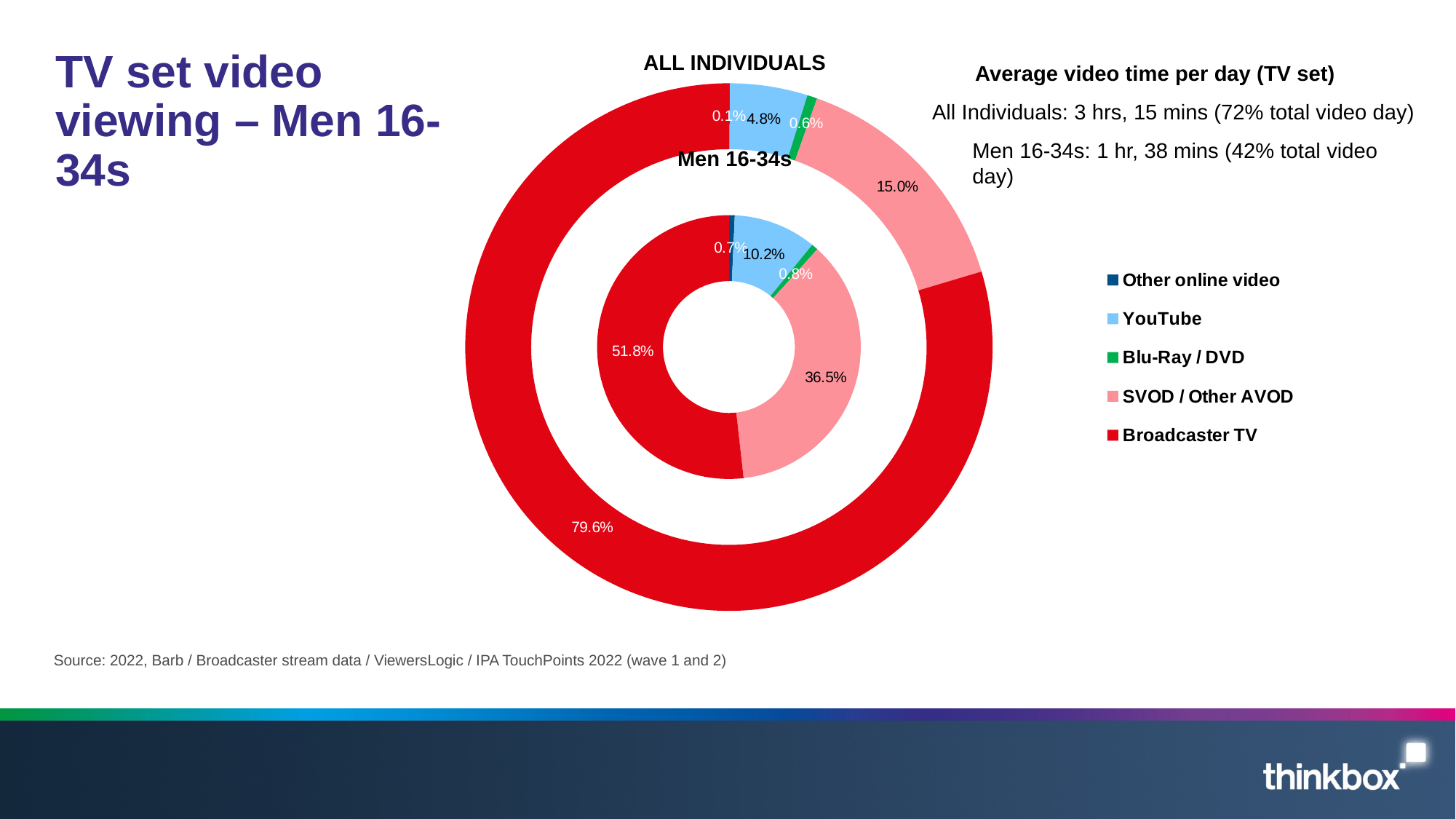
What type of chart is shown on the slide? Doughnut chart What share of TV set video viewing is Broadcaster TV for Men 16-34s (inner ring)? 51.8% What share of TV set video viewing is Broadcaster TV for All Individuals (outer ring)? 79.6% What is the SVOD / Other AVOD share for Men 16-34s? 36.5% What is the difference between the Broadcaster TV share for All Individuals and for Men 16-34s? 27.8 percentage points What is the YouTube share for All Individuals? 4.8% Which category has the smallest share in the All Individuals ring? Other online video Which is larger: the SVOD / Other AVOD share for Men 16-34s or for All Individuals? Men 16-34s How much higher is the YouTube share for Men 16-34s than for All Individuals? 5.4 percentage points Which category has the largest share in the Men 16-34s ring? Broadcaster TV How many categories does the legend list? 5 What is the Blu-Ray / DVD share for Men 16-34s? 0.8%